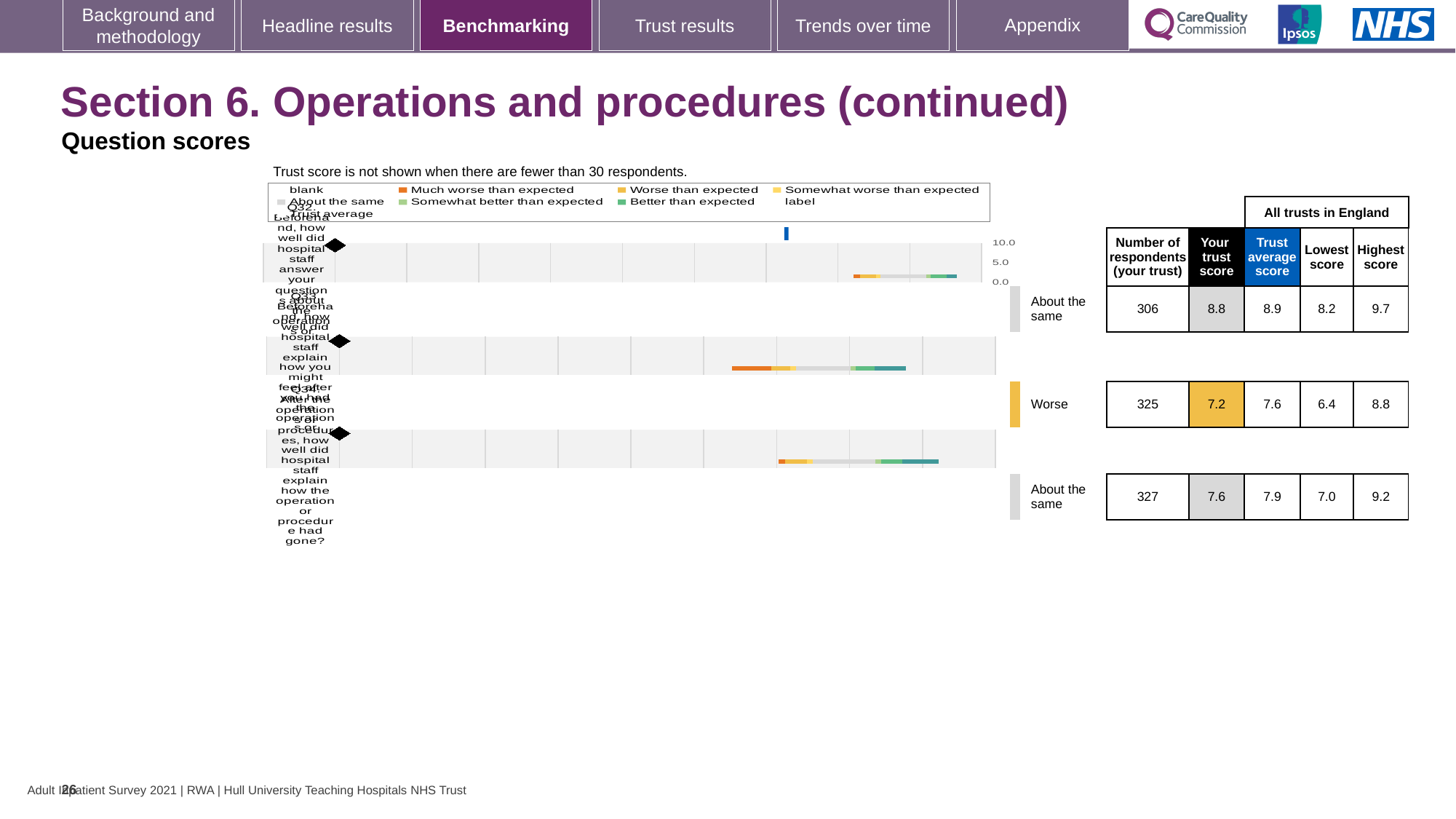
What is the 'Highest score' for the first row (Q32)? 9.7 What is the difference between the 'Trust average score' and 'Your trust score' for the row rated 'Worse'? 0.4 What is the 'Trust average score' for the row rated 'Worse'? 7.6 Which row has the highest 'Your trust score'? the first row (Q32), 8.8 What is the number of respondents for the third (bottom) row? 327 In the table beside the chart, what is the number of respondents for the row rated 'Worse'? 325 What colour does the legend use for 'Much worse than expected'? orange For the third (bottom) row, is 'Your trust score' larger or smaller than the 'Trust average score'? smaller What kind of chart is shown on the slide? bar chart What is the 'Lowest score' for the first row (Q32)? 8.2 How many question rows are plotted in the chart? 3 What is 'Your trust score' for the row rated 'Worse'? 7.2